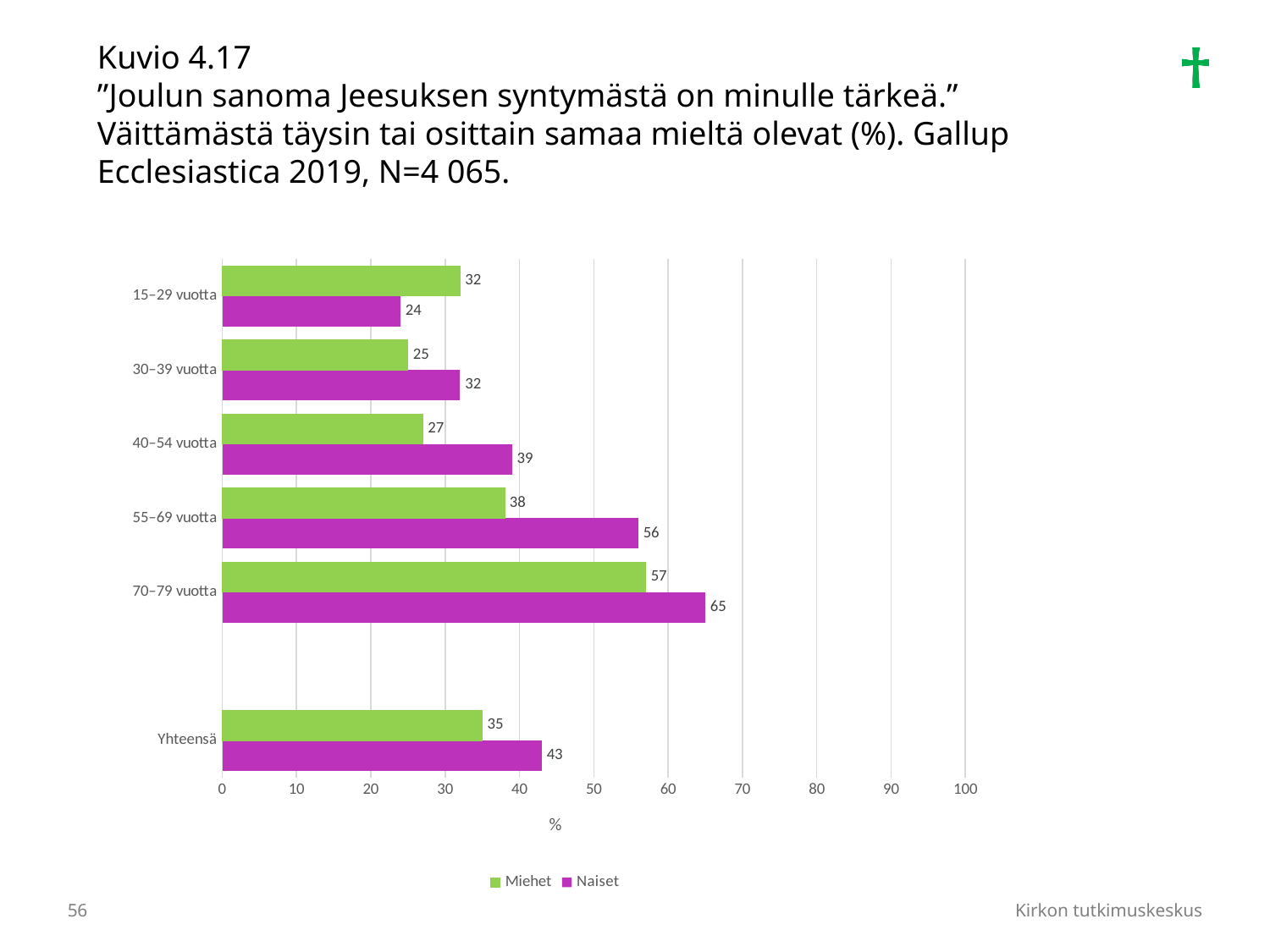
What kind of chart is shown on the slide? Bar chart Which age category has the highest value for Miehet? 70–79 vuotta What is the difference between Naiset and Miehet in the 55–69 vuotta category? 18 How many series does the legend list? 2 Which category has the lowest value for Naiset? 15–29 vuotta What is the value for Naiset in the Yhteensä category? 43 How many categories are shown on the y axis? 6 What is the value for Miehet in the 15–29 vuotta category? 32 Is the value for Naiset in the 40–54 vuotta category greater or less than 30? greater Which colour represents Naiset in the chart? Purple What is the value for Naiset in the 70–79 vuotta category? 65 In the 15–29 vuotta category, which is larger, Miehet or Naiset? Miehet